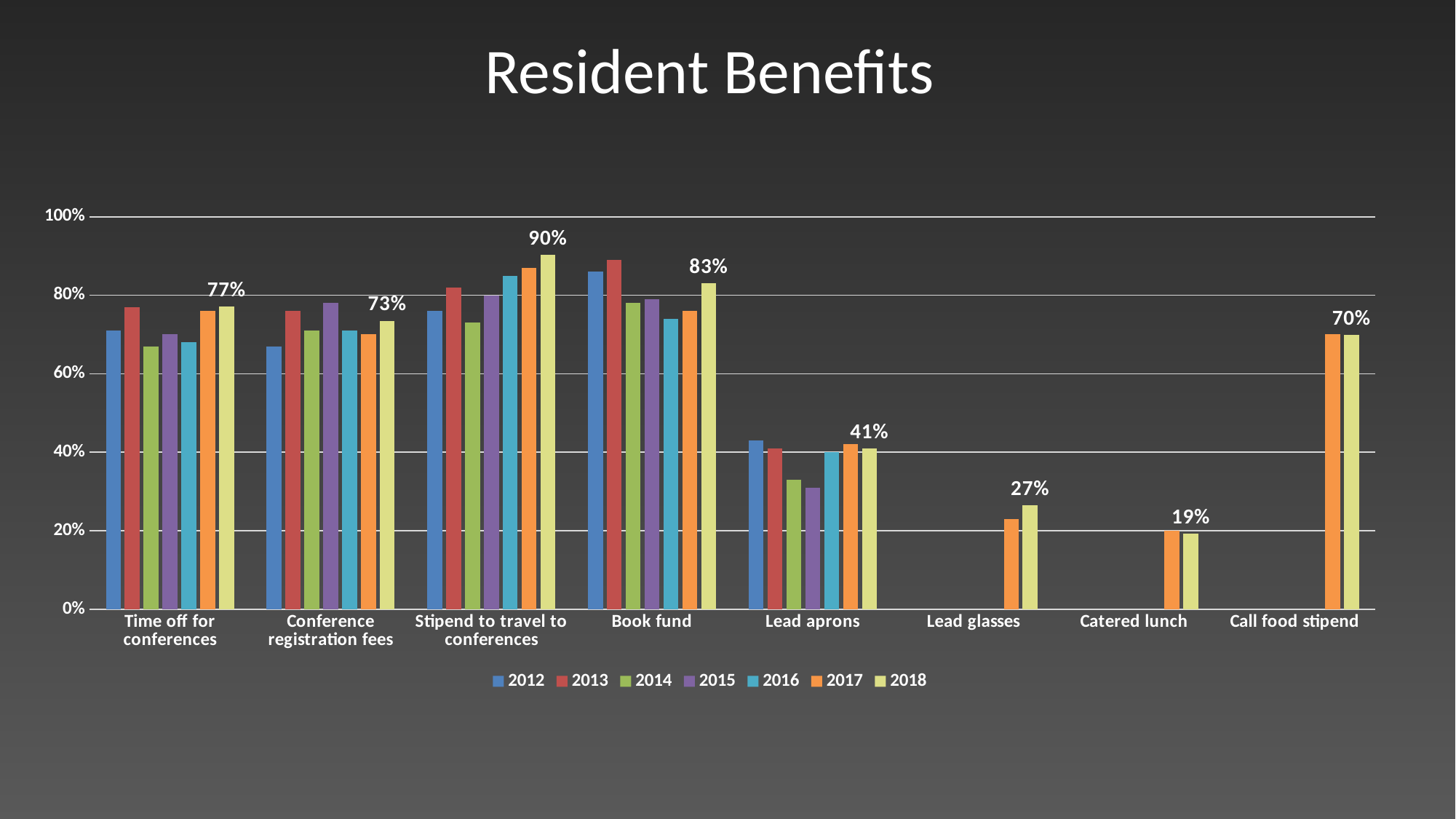
Which is larger in 2018: Book fund or Time off for conferences? Book fund Among the 2018 values, which category is the highest? Stipend to travel to conferences What is the title of the chart? Resident Benefits Among the 2018 values, which category is the lowest? Catered lunch How many series does the legend list? 7 What is the difference between the 2018 values for Stipend to travel to conferences and Book fund? 7 percentage points What is the 2018 value for Stipend to travel to conferences? 90% What is the 2018 value for Lead glasses? 27% What is the 2018 value for Call food stipend? 70% Is the 2012 value for Book fund greater or less than 80%? greater How many benefit categories are shown on the x axis? 8 What kind of chart is shown on the slide? bar chart